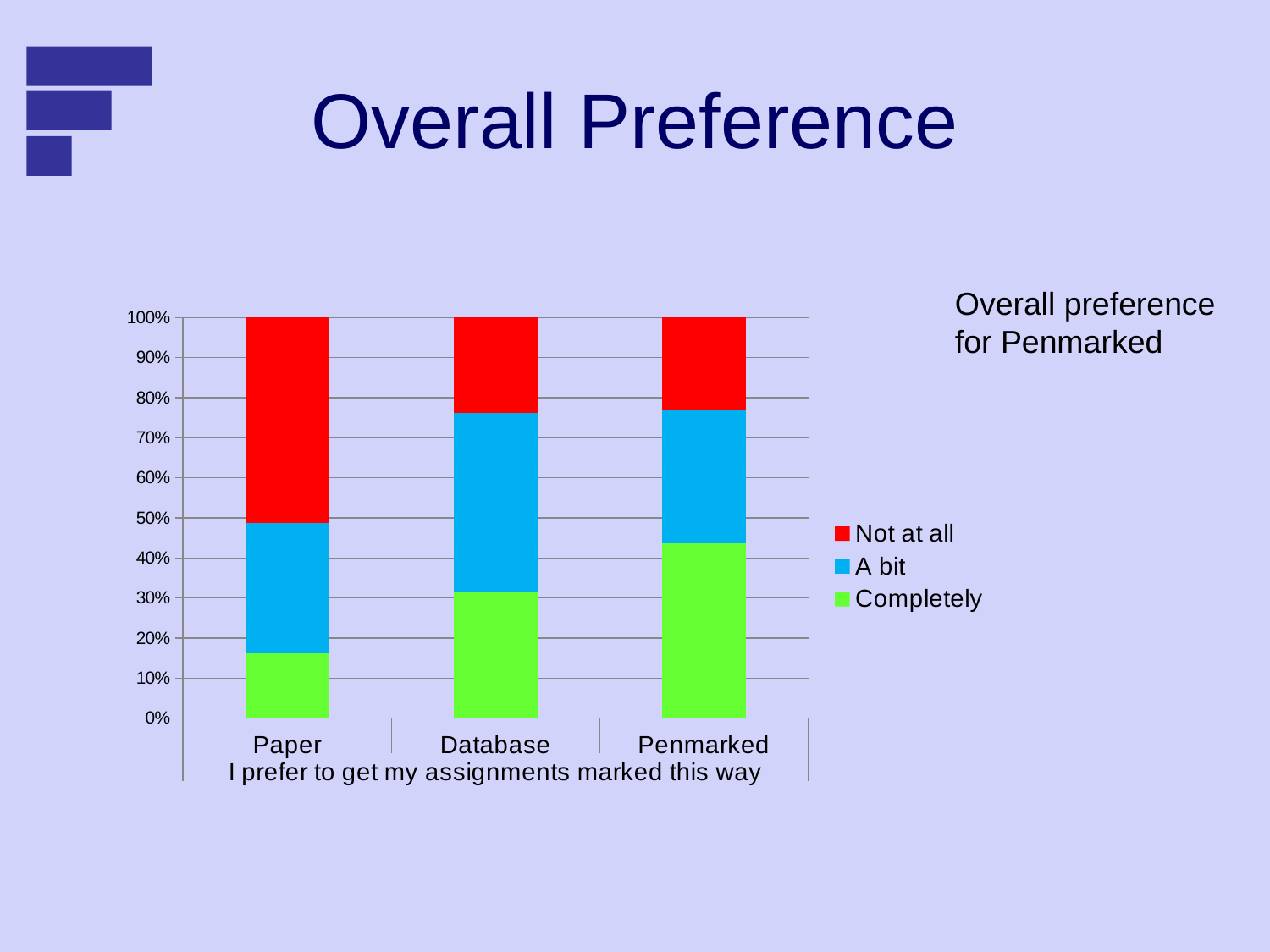
Which category has the largest 'Completely' share? Penmarked Which is larger, the 'Completely' share for Database or for Paper? Database Which category has the largest 'Not at all' share? Paper Is the 'Not at all' value for Paper greater or less than 40%? greater What kind of chart is shown on the slide? Stacked bar chart How many series does the chart's legend list? 3 Is the 'Completely' value for Paper greater or less than 20%? less Is the 'Completely' value for Penmarked greater or less than 40%? greater Which colour represents 'Not at all' in the chart's legend? Red What is the x-axis title of the chart? I prefer to get my assignments marked this way How many categories are shown on the x axis of the chart? 3 Which category has the smallest 'Completely' share? Paper